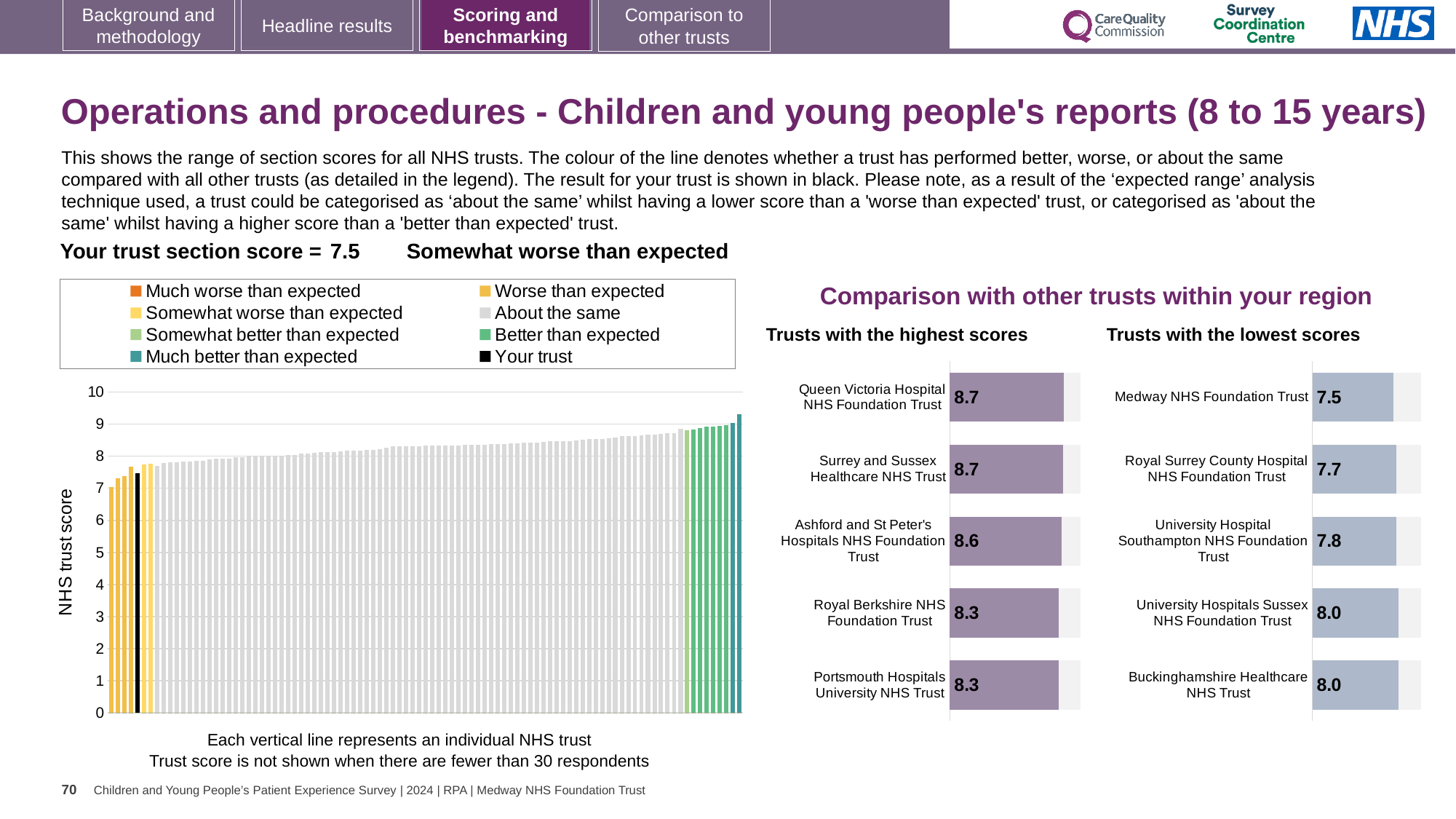
In the 'Trusts with the lowest scores' chart, which has the higher score: Royal Surrey County Hospital NHS Foundation Trust or University Hospital Southampton NHS Foundation Trust? University Hospital Southampton NHS Foundation Trust In the 'Trusts with the lowest scores' chart, what is the difference between the scores of Buckinghamshire Healthcare NHS Trust and Medway NHS Foundation Trust? 0.5 In the 'Trusts with the highest scores' chart, what is the score for Royal Berkshire NHS Foundation Trust? 8.3 What kind of chart is the 'Trusts with the lowest scores' chart? Bar chart In the 'Trusts with the lowest scores' chart, what is the score for Royal Surrey County Hospital NHS Foundation Trust? 7.7 In the NHS trust score chart on the left, is the value for the black 'Your trust' bar greater or less than 8? less In the 'Trusts with the highest scores' chart, what is the score for Ashford and St Peter's Hospitals NHS Foundation Trust? 8.6 In the NHS trust score chart on the left, do the values rise or fall from left to right? Rise How many entries does the legend of the NHS trust score chart on the left list? 8 In the 'Trusts with the lowest scores' chart, which trust has the lowest score? Medway NHS Foundation Trust In the 'Trusts with the highest scores' chart, what is the difference between the scores of Ashford and St Peter's Hospitals NHS Foundation Trust and Portsmouth Hospitals University NHS Trust? 0.3 How many trusts are listed in the 'Trusts with the highest scores' chart? 5